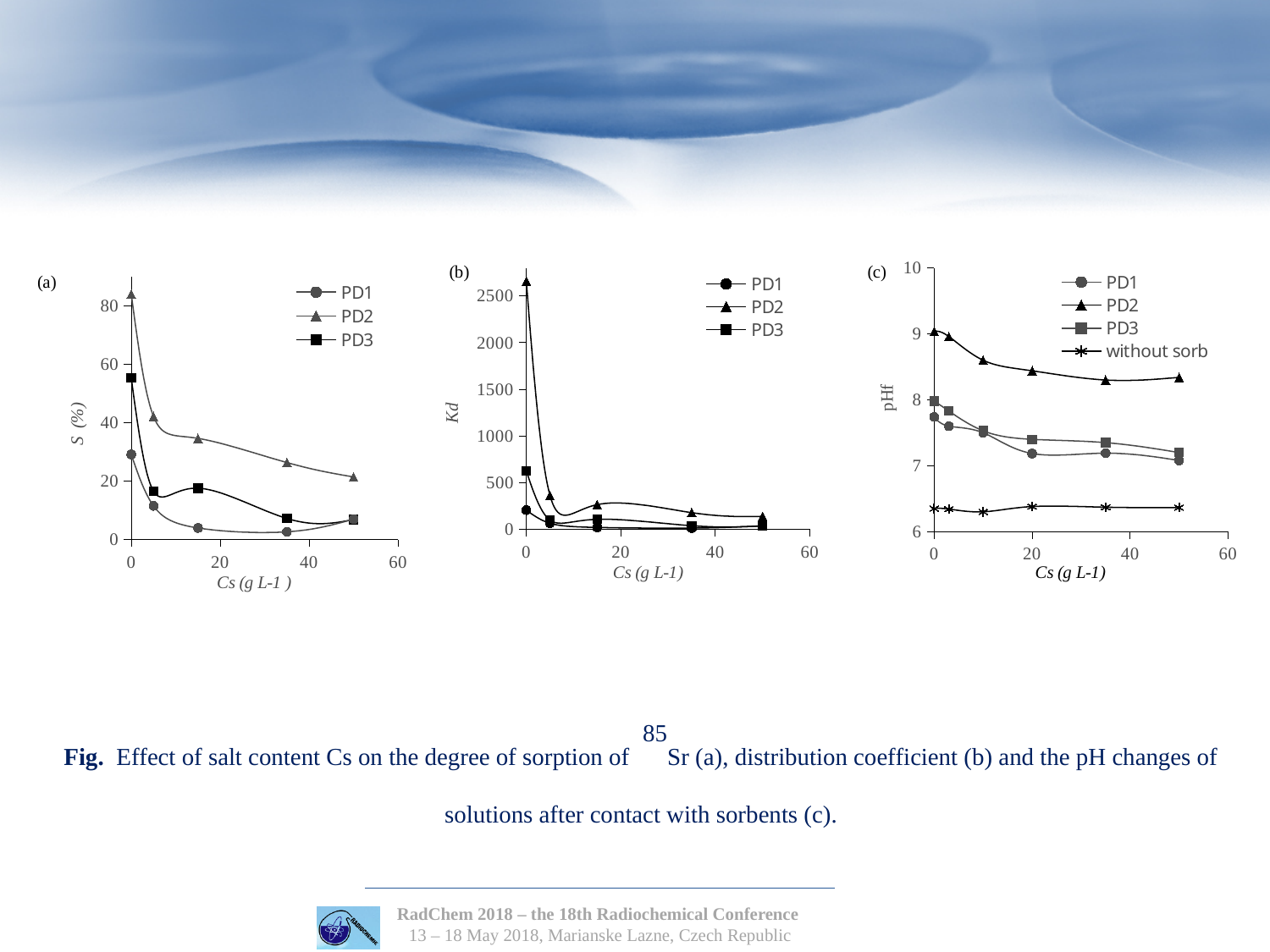
In chart (a), on the left of the slide, is the value of PD3 at Cs = 0 greater or less than 60? less In chart (c), on the right of the slide, is the value of 'without sorb' at Cs = 50 greater or less than 7? less How many series does the legend of chart (a), on the left of the slide, list? 3 How many series does the legend of chart (c), on the right of the slide, list? 4 In chart (b), in the middle of the slide, which series has the lowest value at Cs = 0? PD1 What is the y-axis title of chart (c), on the right of the slide? pHf In chart (b), in the middle of the slide, is the value of PD1 at Cs = 0 greater or less than 500? less In chart (a), on the left of the slide, which series has the highest value at Cs = 0? PD2 In chart (c), on the right of the slide, which is larger at Cs = 50: PD2 or PD1? PD2 What kind of chart is chart (a), on the left of the slide? line chart In chart (a), on the left of the slide, do the values of PD2 rise or fall as Cs increases? fall